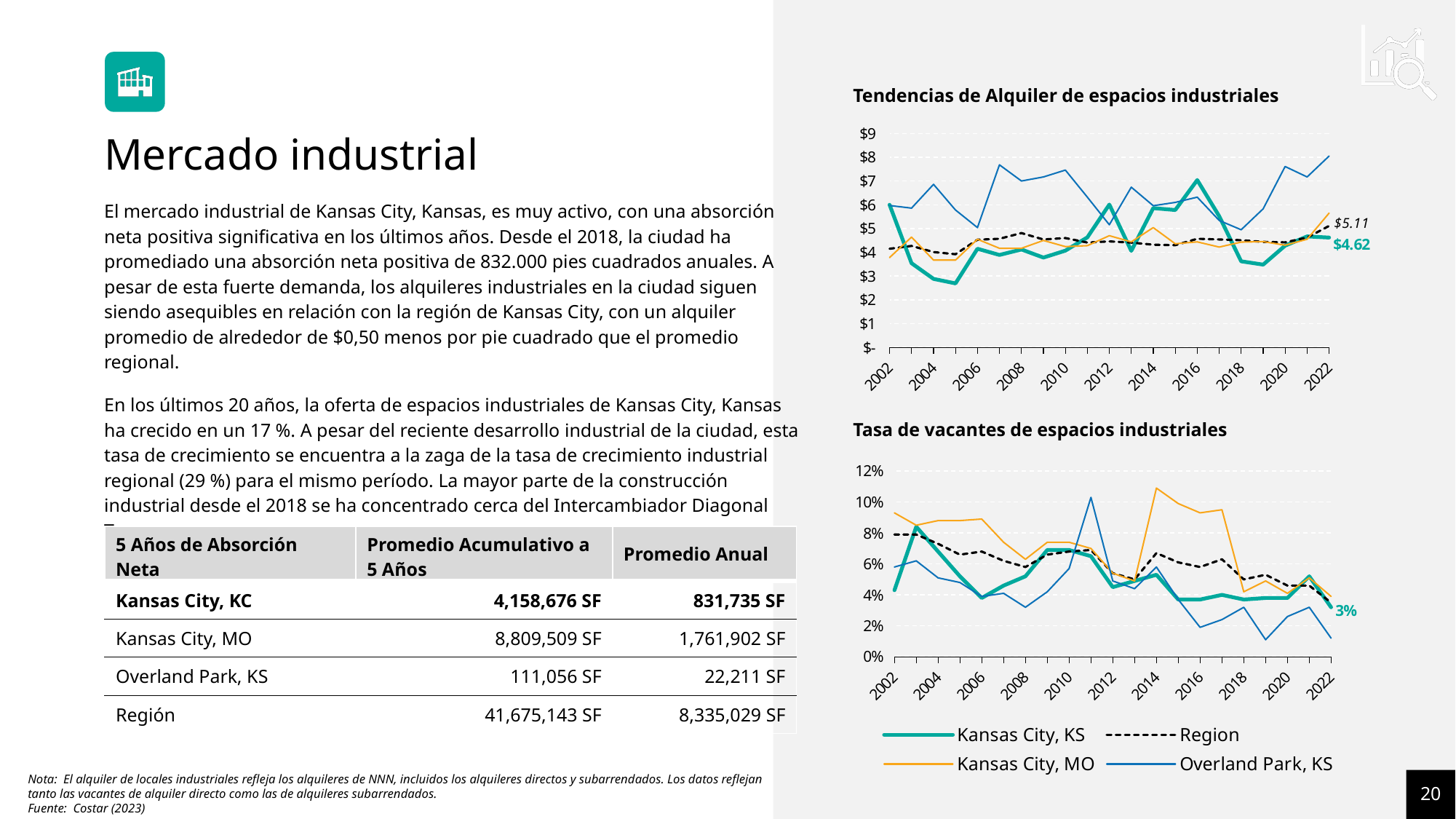
In the 'Tasa de vacantes de espacios industriales' chart, what is the labeled 2022 value for Kansas City, KS? 3% How many series does the legend below the charts list? 4 In the 'Tendencias de Alquiler de espacios industriales' chart, what is the difference between the 2022 Region value and the 2022 Kansas City, KS value? $0.49 What kind of chart is 'Tendencias de Alquiler de espacios industriales'? line chart In the 'Tendencias de Alquiler de espacios industriales' chart, is the 2022 value for Overland Park, KS greater or less than $7? greater In the 'Tendencias de Alquiler de espacios industriales' chart, does the Overland Park, KS line rise or fall from 2018 to 2022? rise In the 'Tendencias de Alquiler de espacios industriales' chart, what is the labeled 2022 value for Kansas City, KS? $4.62 In the 'Tasa de vacantes de espacios industriales' chart, is the 2014 value for Kansas City, MO greater or less than 10%? greater In the 'Tendencias de Alquiler de espacios industriales' chart, which series has the highest value in 2022? Overland Park, KS In the 'Tasa de vacantes de espacios industriales' chart, which series has the lowest value in 2022? Overland Park, KS In the 'Tendencias de Alquiler de espacios industriales' chart, what is the labeled 2022 value for Region? $5.11 What is the title of the lower chart on the slide? Tasa de vacantes de espacios industriales